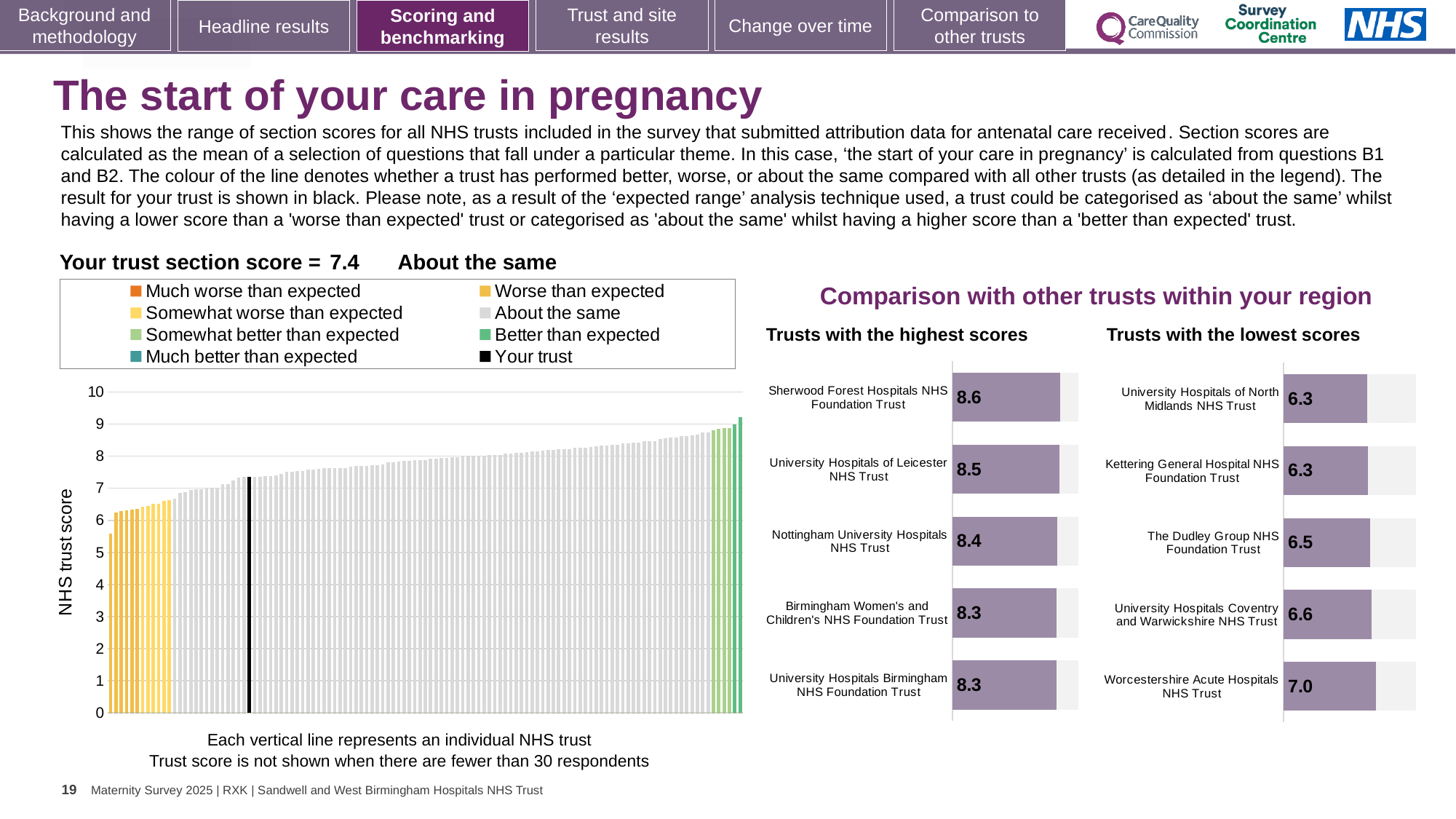
In the main 'NHS trust score' chart on the left, do the trust scores rise or fall from left to right? rise In the main 'NHS trust score' chart on the left, what is the section score for your trust (the black bar)? 7.4 In the 'Trusts with the highest scores' chart, what is the score for Sherwood Forest Hospitals NHS Foundation Trust? 8.6 In the 'Trusts with the lowest scores' chart, which has the larger score: The Dudley Group NHS Foundation Trust or University Hospitals Coventry and Warwickshire NHS Trust? University Hospitals Coventry and Warwickshire NHS Trust In the 'Trusts with the lowest scores' chart, what is the score for The Dudley Group NHS Foundation Trust? 6.5 In the 'Trusts with the lowest scores' chart, what is the difference between the scores of Worcestershire Acute Hospitals NHS Trust and Kettering General Hospital NHS Foundation Trust? 0.7 How many entries does the legend of the main 'NHS trust score' chart on the left list? 8 In the 'Trusts with the lowest scores' chart, which trust has the highest score? Worcestershire Acute Hospitals NHS Trust How many trusts are shown in the 'Trusts with the highest scores' chart? 5 In the 'Trusts with the highest scores' chart, what is the score for Nottingham University Hospitals NHS Trust? 8.4 In the 'Trusts with the highest scores' chart, what is the difference between the scores of Sherwood Forest Hospitals NHS Foundation Trust and University Hospitals Birmingham NHS Foundation Trust? 0.3 In the 'Trusts with the highest scores' chart, which trust has the highest score? Sherwood Forest Hospitals NHS Foundation Trust